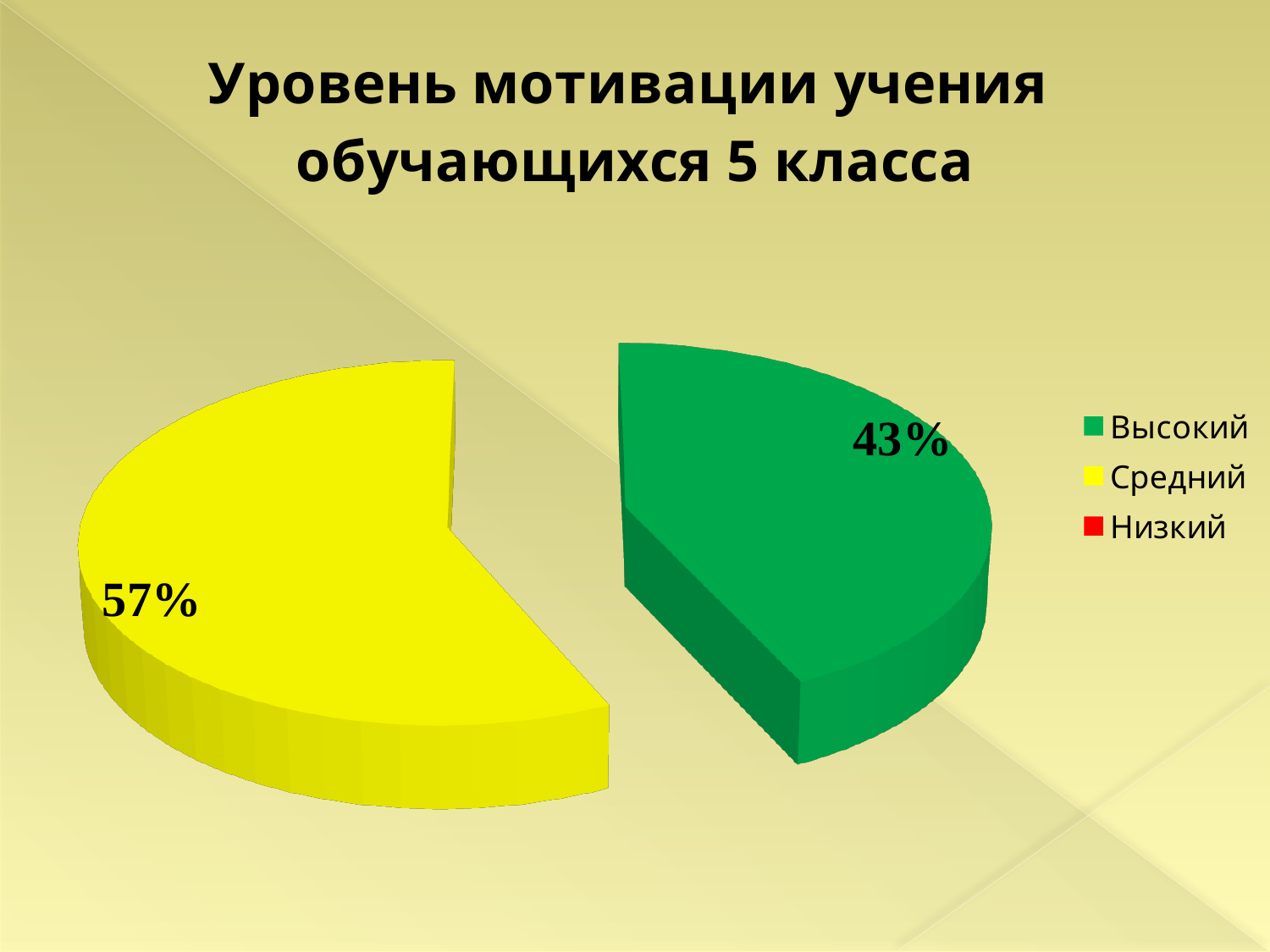
Which category has the largest slice of the pie? Средний Which is larger, the Высокий slice or the Средний slice? Средний What share of the pie does the Высокий slice represent? 43% What share of the pie does the Средний slice represent? 57% What kind of chart is shown on the slide? Pie chart By how many percentage points does the Средний slice exceed the Высокий slice? 14 percentage points What is the title of the chart? Уровень мотивации учения обучающихся 5 класса Which of the two labelled slices, Высокий or Средний, is smaller? Высокий What colour represents the Высокий category in the legend? Green How many slices with data labels are visible in the pie? 2 Is the share for Высокий greater or less than 50%? less How many entries does the legend list? 3